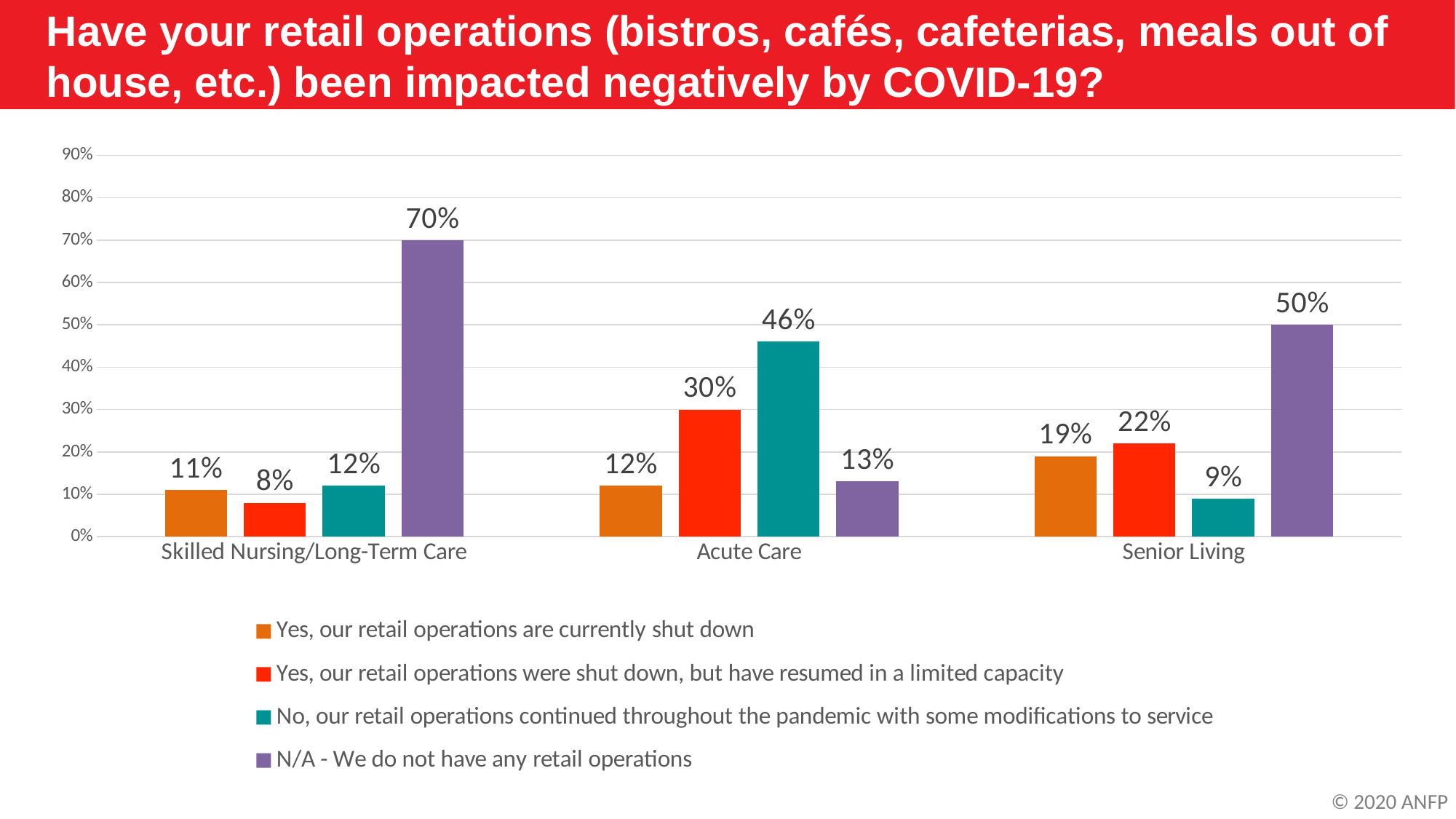
What percentage of Skilled Nursing/Long-Term Care respondents answered "N/A - We do not have any retail operations"? 70% What percentage of Acute Care respondents said their retail operations continued throughout the pandemic with some modifications to service? 46% What percentage of Senior Living respondents said their retail operations were shut down but have resumed in a limited capacity? 22% How many categories are shown on the x axis? 3 Which category has the highest value for "Yes, our retail operations are currently shut down"? Senior Living Which category has the lowest value for "No, our retail operations continued throughout the pandemic with some modifications to service"? Senior Living What kind of chart is shown on the slide? Bar chart Is the value for "N/A - We do not have any retail operations" in Acute Care greater or less than 20%? less What is the difference between the "N/A - We do not have any retail operations" values for Skilled Nursing/Long-Term Care and Senior Living? 20% What colour represents "N/A - We do not have any retail operations" in the legend? Purple Which is larger for Acute Care: "Yes, our retail operations were shut down, but have resumed in a limited capacity" or "N/A - We do not have any retail operations"? Yes, our retail operations were shut down, but have resumed in a limited capacity How many series does the legend list? 4